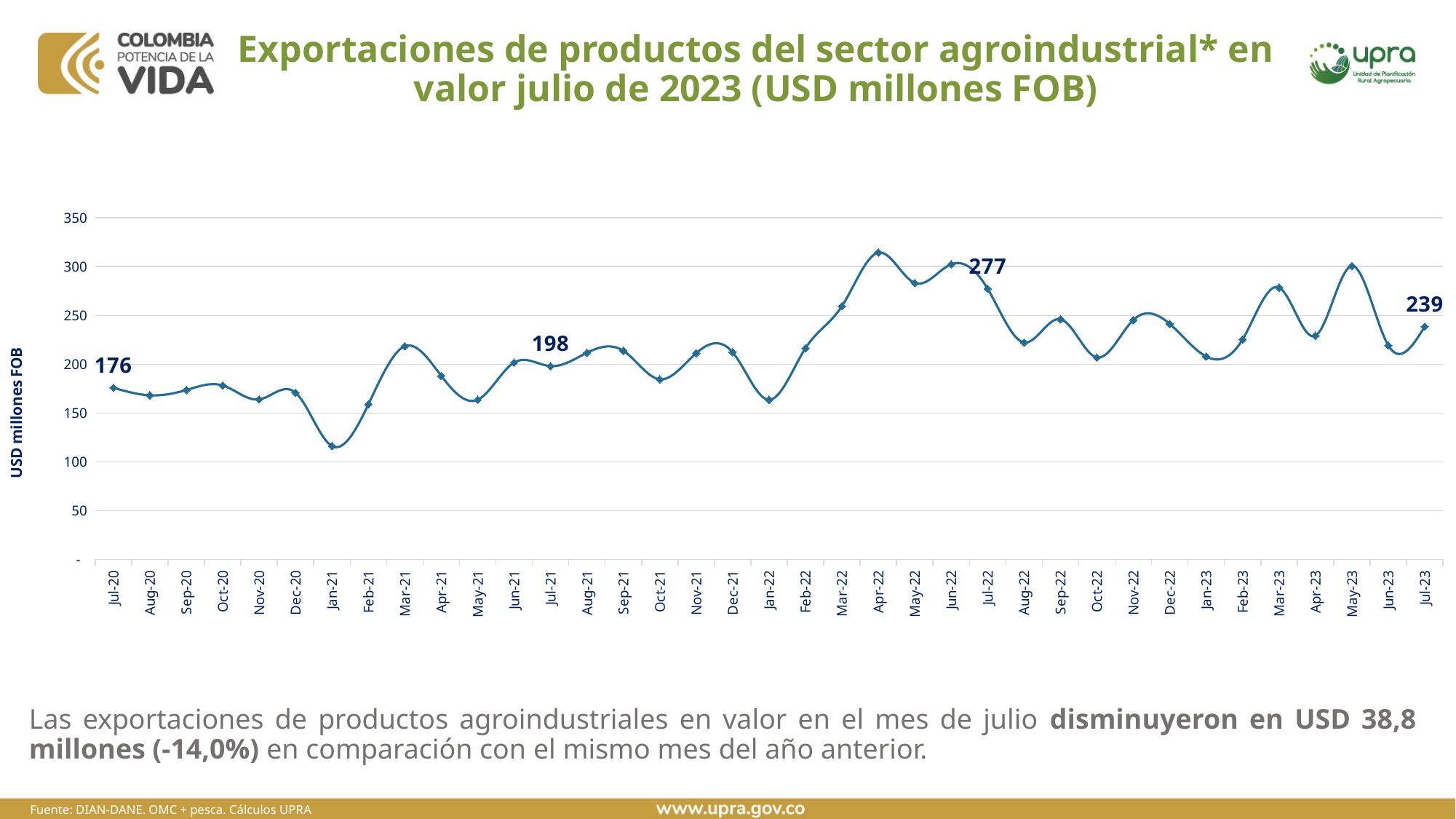
What is the value for Jul-20? 176 Which month has the highest value on the chart? Apr-22 What is the value for Jul-22? 277 What is the value for Jul-23? 239 Which is larger, the value for Jul-22 or the value for Jul-23? Jul-22 Which month has the lowest value on the chart? Jan-21 What is the difference between the values for Jul-22 and Jul-23? 38,8 Is the value for Apr-22 greater or less than 300? greater What kind of chart is shown on the slide? line chart What is the value for Jul-21? 198 Is the value for Jan-21 greater or less than 150? less How many monthly data points are plotted on the chart? 37